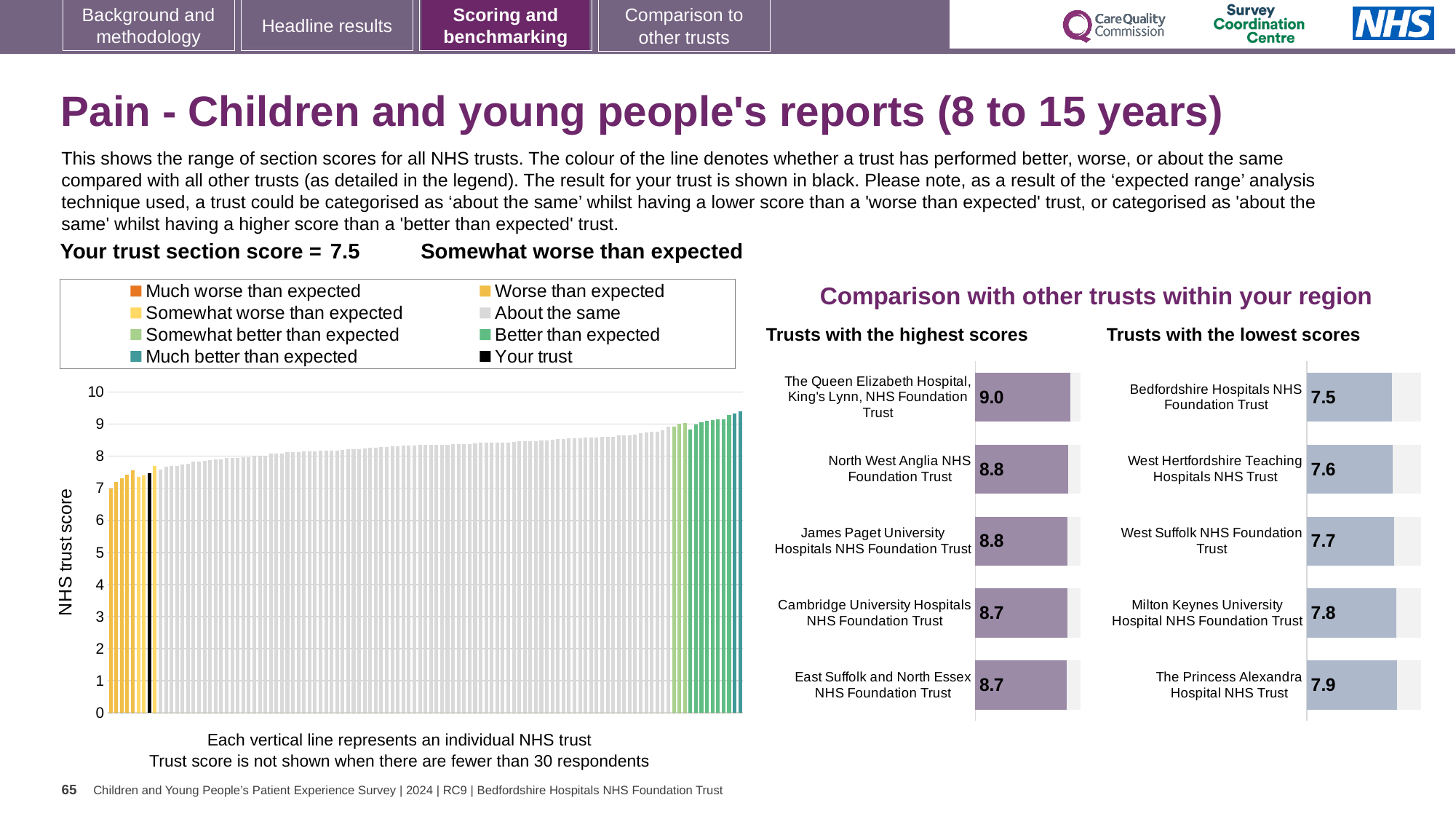
In the 'Trusts with the lowest scores' chart, which trust has the lowest score? Bedfordshire Hospitals NHS Foundation Trust What kind of chart is the main chart on the left showing the range of section scores for all NHS trusts? Bar chart In the 'Trusts with the lowest scores' chart, what is the score for West Hertfordshire Teaching Hospitals NHS Trust? 7.6 In the main chart on the left, do the trust scores rise or fall from left to right? Rise In the main chart on the left, how many entries does the legend list? 8 In the 'Trusts with the lowest scores' chart, which has the larger score: Milton Keynes University Hospital NHS Foundation Trust or West Suffolk NHS Foundation Trust? Milton Keynes University Hospital NHS Foundation Trust In the 'Trusts with the highest scores' chart, what is the difference between the scores of The Queen Elizabeth Hospital, King's Lynn and Cambridge University Hospitals NHS Foundation Trust? 0.3 In the 'Trusts with the highest scores' chart, what is the score for The Queen Elizabeth Hospital, King's Lynn, NHS Foundation Trust? 9.0 In the 'Trusts with the highest scores' chart, which trust has the highest score? The Queen Elizabeth Hospital, King's Lynn, NHS Foundation Trust In the main chart on the left showing the range of section scores, is the value for 'Your trust' greater or less than 5? greater In the 'Trusts with the lowest scores' chart, what is the difference between the scores of The Princess Alexandra Hospital NHS Trust and Bedfordshire Hospitals NHS Foundation Trust? 0.4 In the 'Trusts with the highest scores' chart, how many trusts are shown? 5